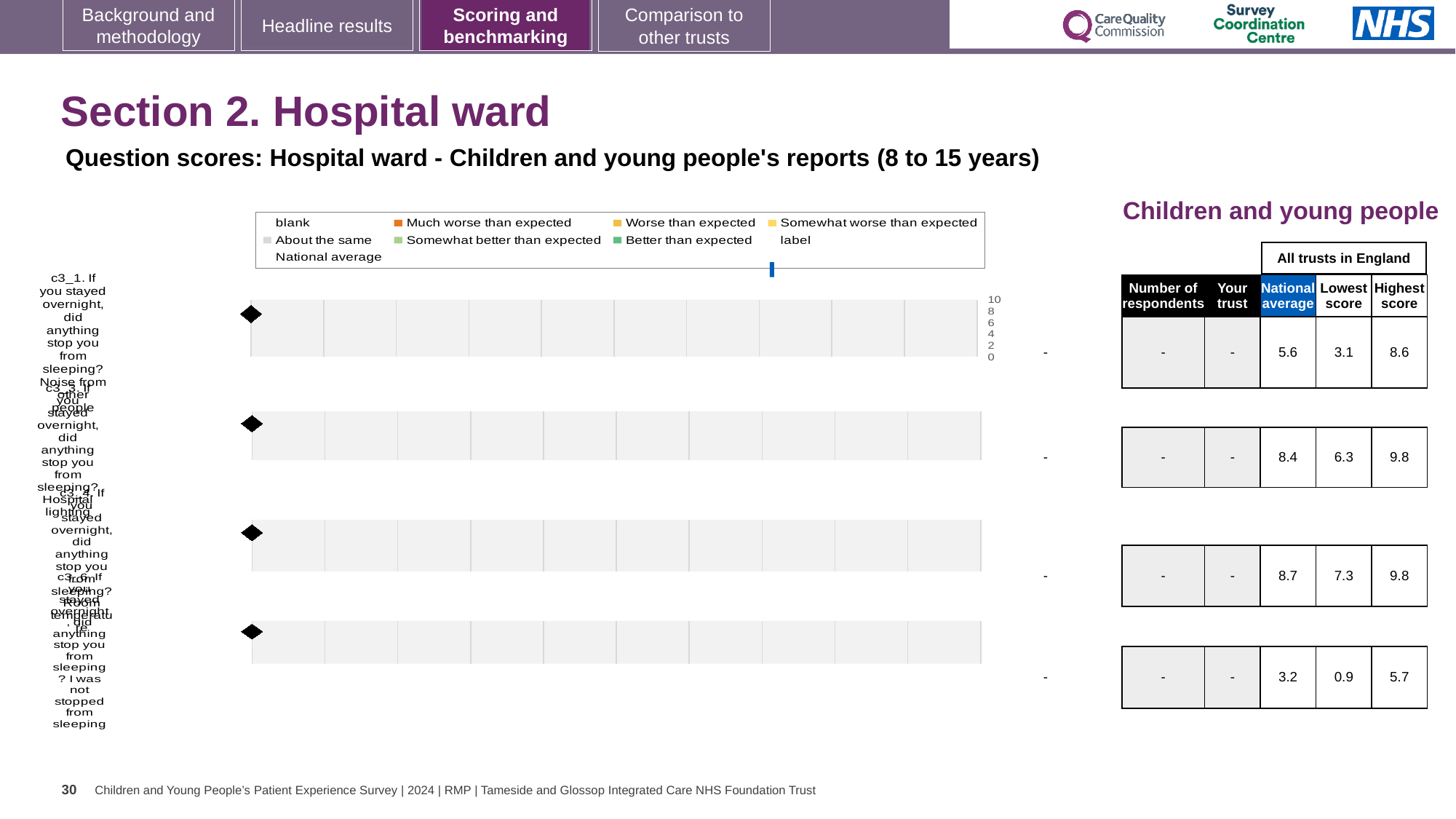
What is the difference between the Highest score and the Lowest score for question c3_1? 5.5 Which question has the lowest National average in the table? c3_6 (I was not stopped from sleeping) What is the highest tick value shown on the chart's axis? 10 Which has the larger National average, question c3_3 or question c3_4? c3_4 How many question rows (bars) does the chart show? 4 What value is shown in the 'Your trust' column for each question? - In the table, what is the Highest score for question c3_3 (hospital lighting)? 9.8 Which question has the highest National average in the table? c3_4 (room temperature) What kind of chart is shown on the slide? bar chart In the table, what is the National average for question c3_1 (noise from other people)? 5.6 In the table, what is the Lowest score for question c3_6 (I was not stopped from sleeping)? 0.9 What colour is the legend marker for 'Much worse than expected'? orange